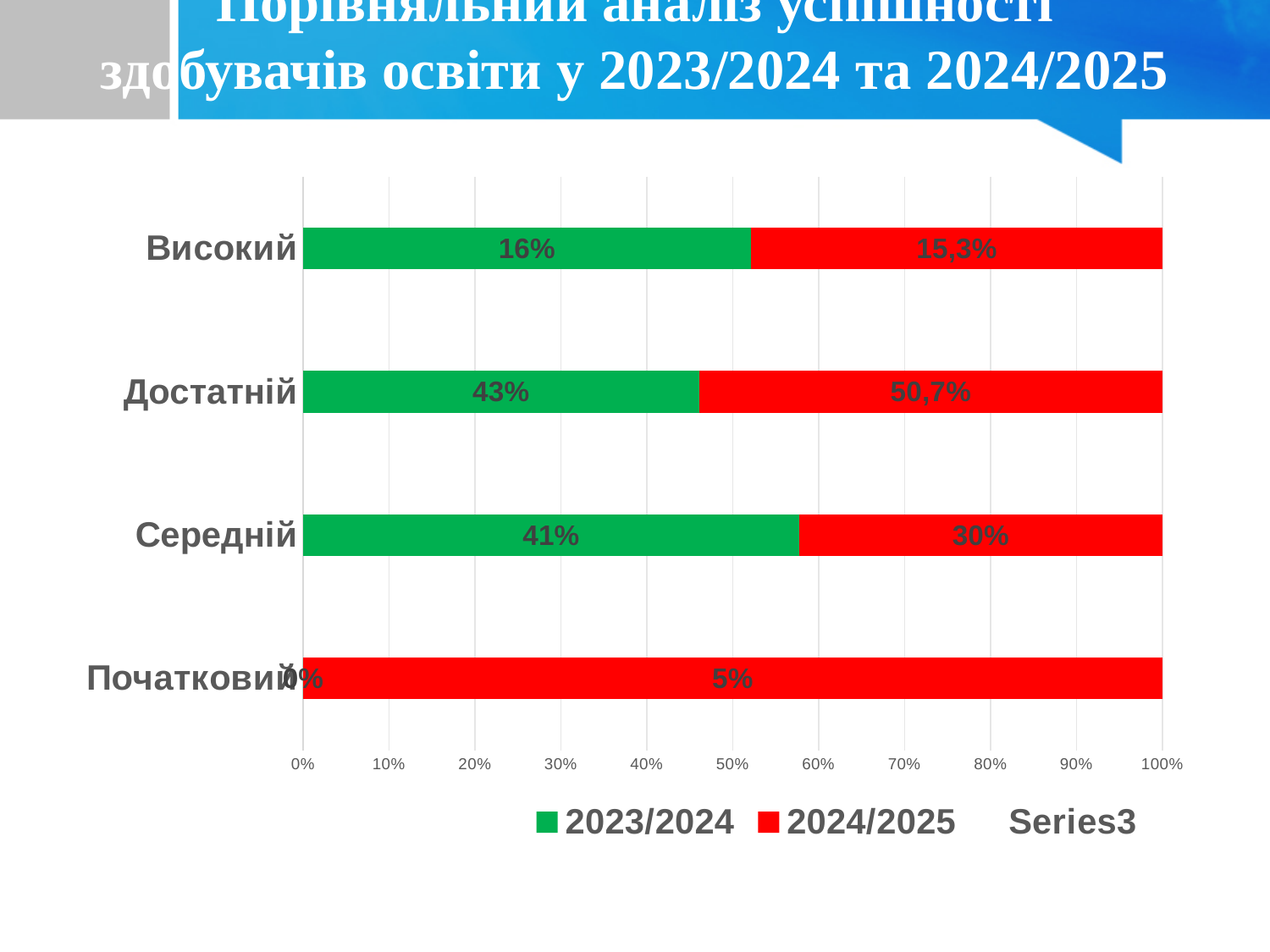
What kind of chart is shown on the slide? Stacked bar chart Which category has the highest value in the 2024/2025 series? Достатній Which category has the lowest value in the 2023/2024 series? Початковий What is the value for Початковий in the 2023/2024 series? 0% What is the value for Середній in the 2024/2025 series? 30% Which is larger for Середній: the 2023/2024 value or the 2024/2025 value? 2023/2024 How many series does the legend list? 3 How many categories are shown on the chart? 4 What is the value for Достатній in the 2024/2025 series? 50,7% What is the value for Високий in the 2023/2024 series? 16% What is the difference between the 2023/2024 values for Достатній and Середній? 2% What is the difference between the 2024/2025 values for Достатній and Середній? 20,7%